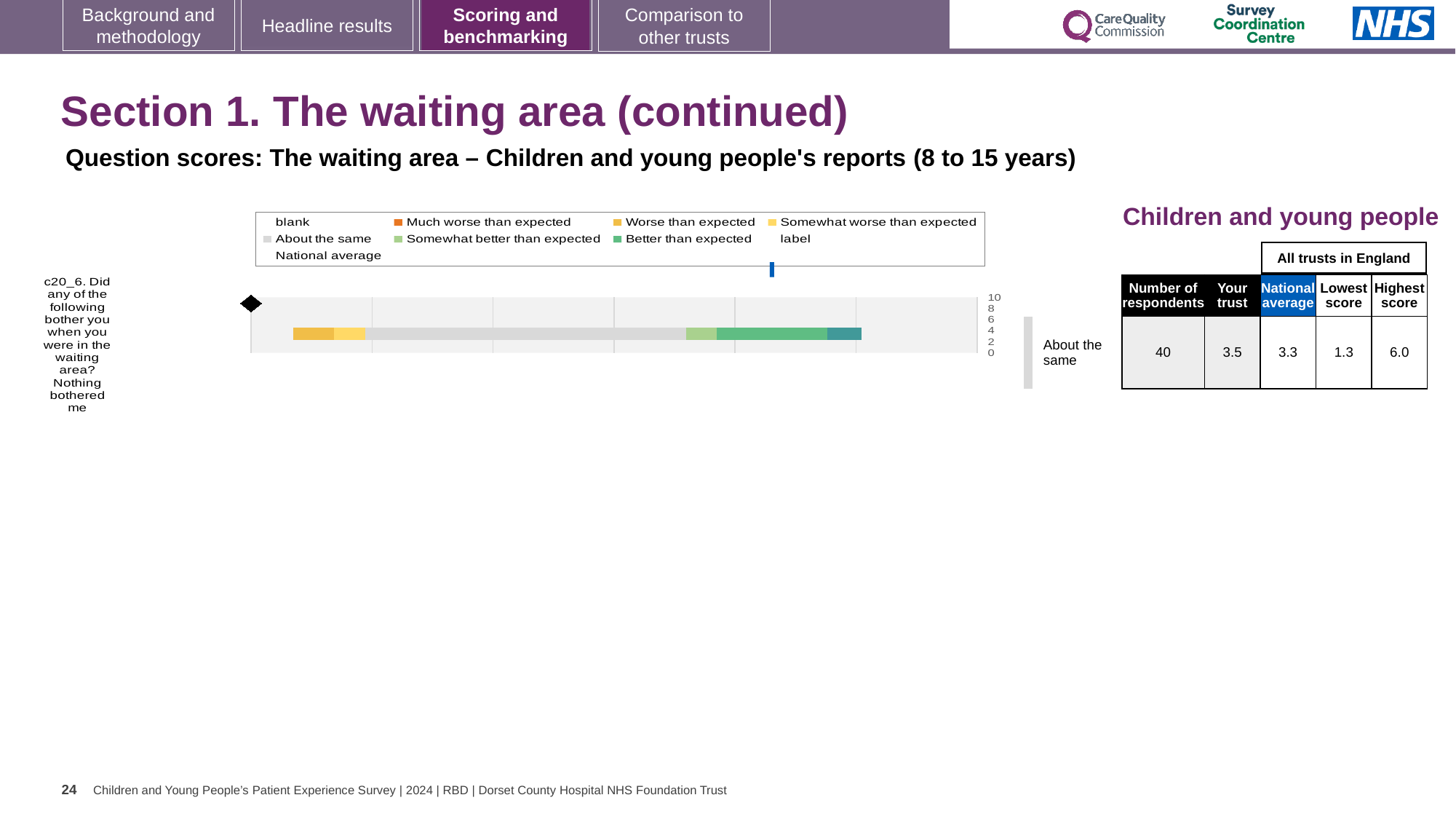
In the table beside the chart, what is the lowest score among all trusts in England for question c20_6? 1.3 Which is larger for question c20_6: the 'Your trust' score or the national average? Your trust What type of chart is used to show the question score for c20_6? bar chart In the table beside the chart, how many respondents answered question c20_6? 40 What is the difference between the 'Your trust' score and the national average for question c20_6? 0.2 In the table beside the chart, what is the national average score for question c20_6? 3.3 What benchmark label is shown to the right of the bar for question c20_6? About the same What is the difference between the highest score and the lowest score for question c20_6? 4.7 How many survey questions are plotted in the chart? 1 In the table beside the chart, what is the highest score among all trusts in England for question c20_6? 6.0 How many entries does the chart legend list? 9 In the table beside the chart, what is the 'Your trust' score for question c20_6? 3.5